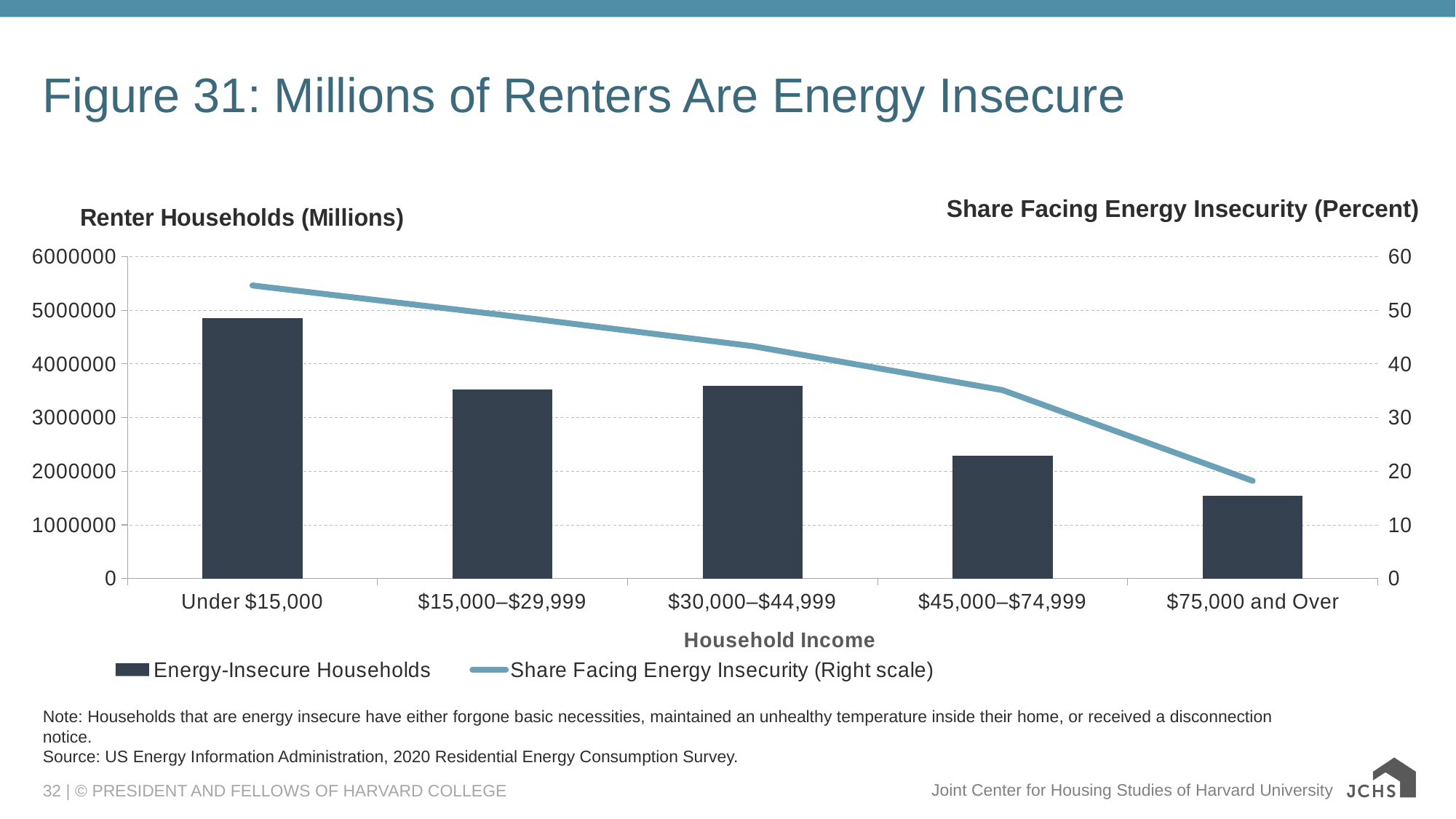
What kind of chart is shown on the slide? A combined bar and line chart Is the number of energy-insecure households for $75,000 and Over greater or less than 2000000? less Is the share facing energy insecurity for $75,000 and Over greater or less than 20 percent? less Which has more energy-insecure households: Under $15,000 or $45,000–$74,999? Under $15,000 How many household income categories are shown on the x axis? 5 Which household income category has the lowest number of energy-insecure households? $75,000 and Over Is the share facing energy insecurity for Under $15,000 greater or less than 50 percent? greater How many series does the legend list? 2 How does the share facing energy insecurity change as household income rises along the x axis? It falls Which household income category has the highest number of energy-insecure households? Under $15,000